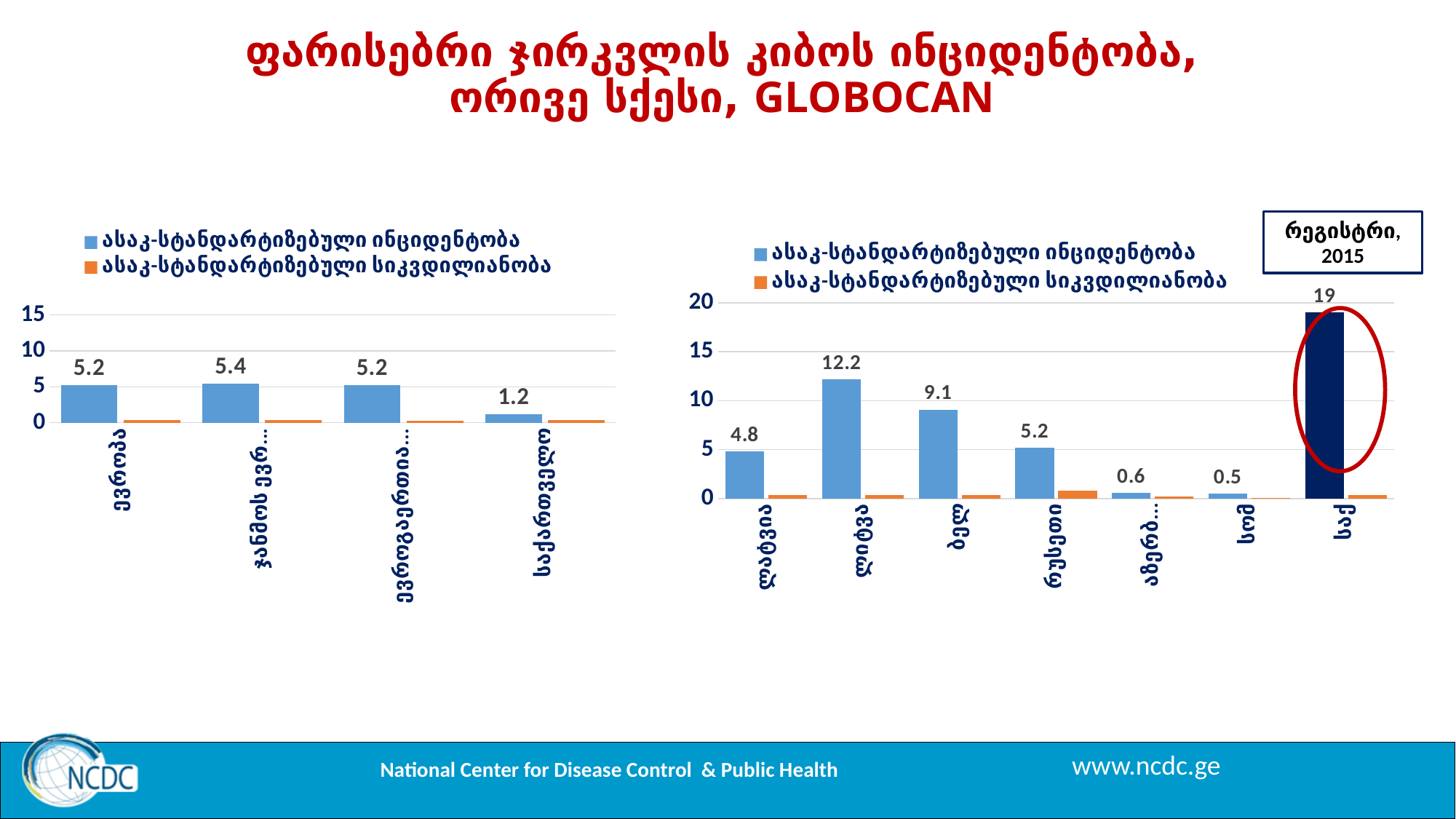
In the right chart, what is the difference between the incidence values for ლიტვა and ლატვია? 7.4 In the right chart, which category has the lowest age-standardized incidence? სომ In the right chart, which has a higher incidence value, რუსეთი or ლატვია? რუსეთი In the left chart, what is the age-standardized incidence value for საქართველო? 1.2 In the left chart, how many categories are shown on the x axis? 4 In the left chart, what is the age-standardized incidence value for ევროპა? 5.2 In the right chart, how many series does the legend list? 2 What type of chart is the right chart? Bar chart In the right chart, what is the age-standardized incidence value for ლიტვა? 12.2 In the left chart, which category has the lowest age-standardized incidence? საქართველო In the right chart, which category has the highest age-standardized incidence? საქ